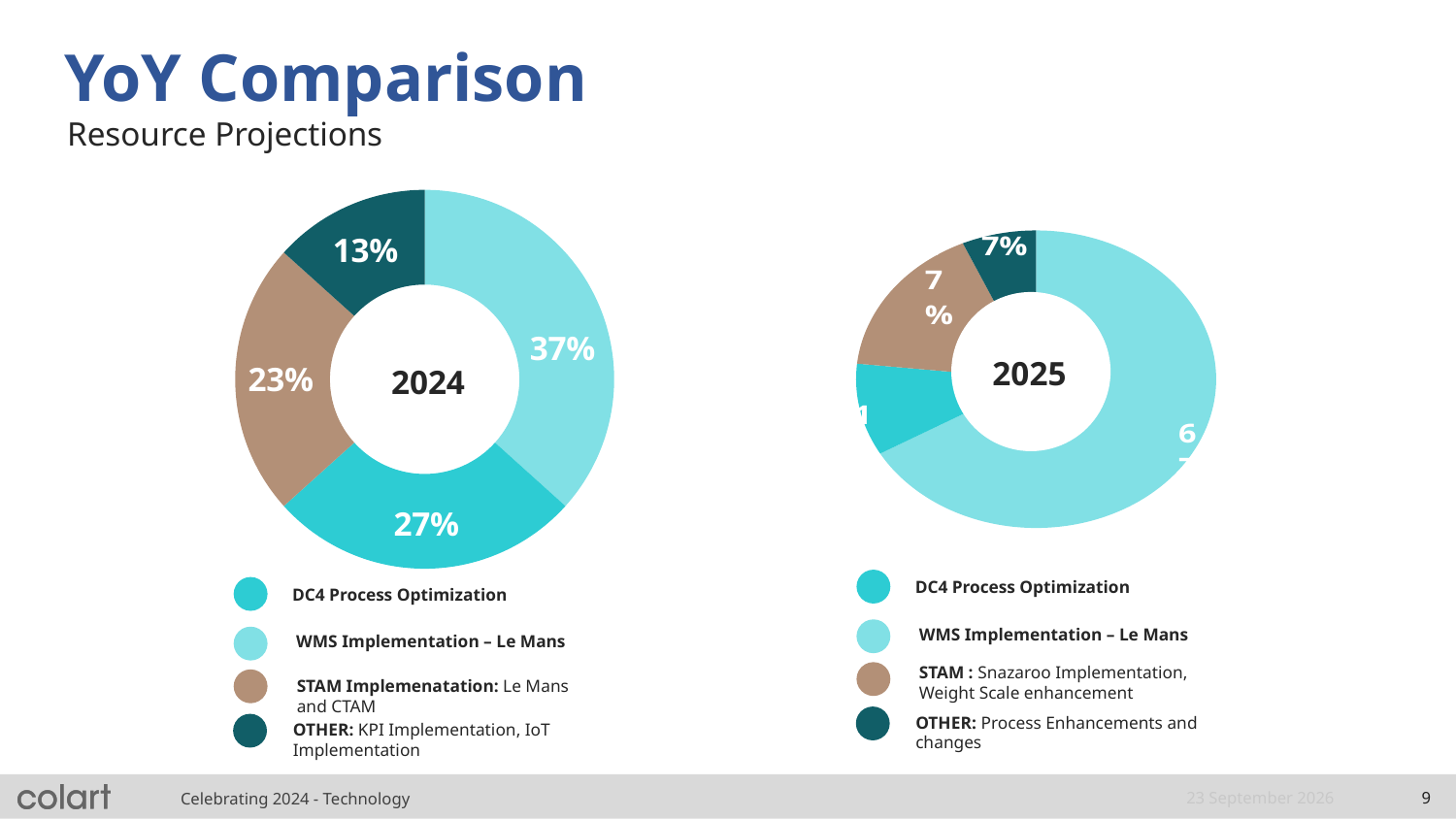
In the 2024 chart, what percentage is shown for WMS Implementation – Le Mans? 37% In the 2024 chart, what is the difference in percentage points between WMS Implementation – Le Mans and OTHER? 24 In the 2025 chart, what percentage is shown for OTHER? 7% What kind of chart is the 2024 chart? Donut (pie) chart In the 2024 chart, which category has the largest share? WMS Implementation – Le Mans How many categories does the legend of the 2024 chart list? 4 In the 2024 chart, what percentage is shown for STAM Implemenatation? 23% In the 2024 chart, which is larger: DC4 Process Optimization or STAM Implemenatation? DC4 Process Optimization In the 2024 chart, which category has the smallest share? OTHER In the 2025 chart, which category has the largest share? WMS Implementation – Le Mans In the 2024 chart, what percentage is shown for DC4 Process Optimization? 27% In the 2024 chart, what percentage is shown for OTHER? 13%